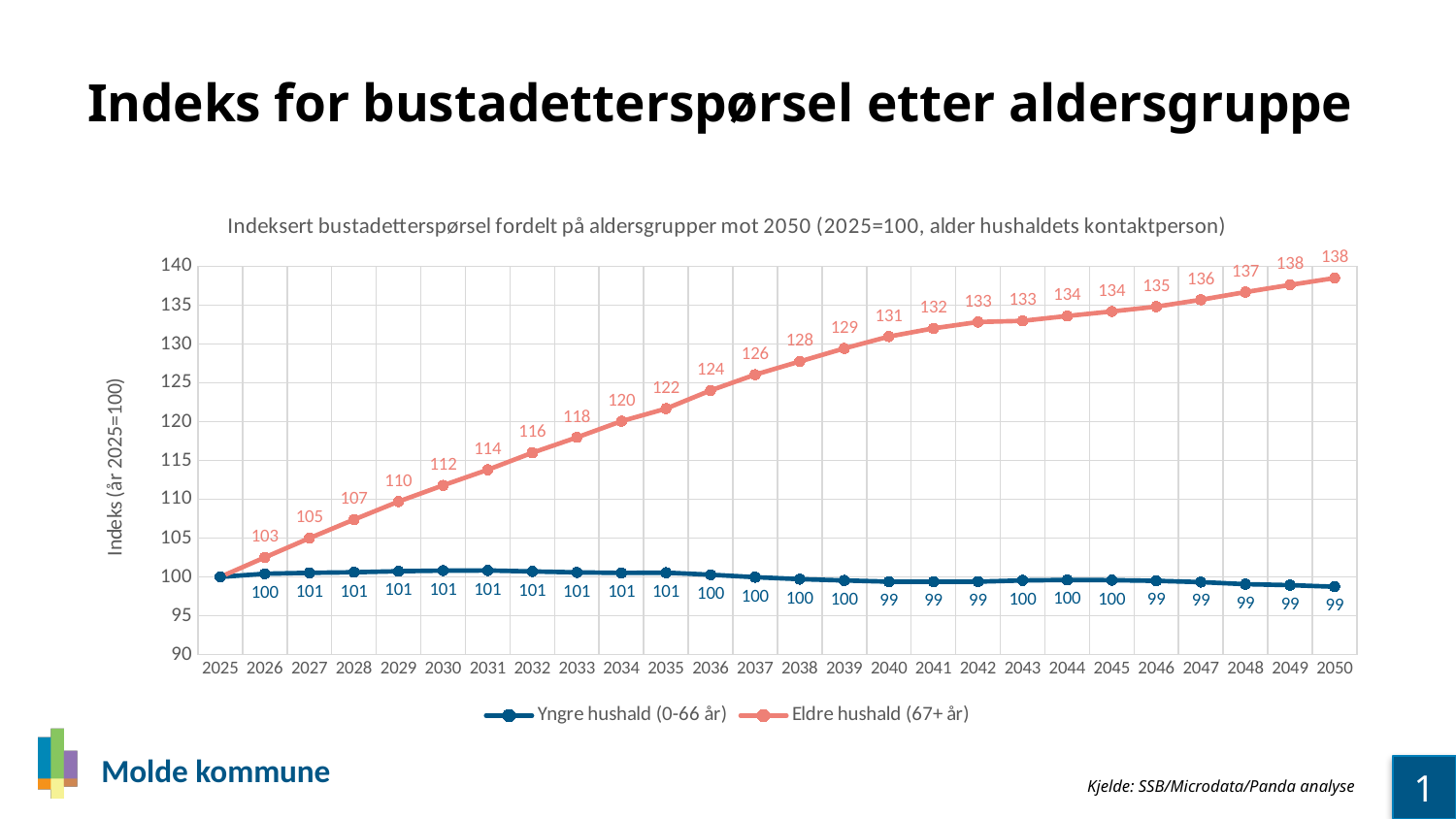
In 2035, which series has the higher value, Eldre hushald (67+ år) or Yngre hushald (0-66 år)? Eldre hushald (67+ år) Does the Eldre hushald (67+ år) series rise or fall from 2025 to 2050? rise How many years are shown on the x axis? 26 What kind of chart is shown on the slide? line chart What is the value for Eldre hushald (67+ år) in 2050? 138 What is the value for Eldre hushald (67+ år) in 2040? 131 What is the difference between the Eldre hushald (67+ år) and Yngre hushald (0-66 år) values in 2050? 39 What is the value for Yngre hushald (0-66 år) in 2050? 99 How many series does the legend list? 2 Is the value for Eldre hushald (67+ år) in 2036 greater or less than 120? greater What is the value for Eldre hushald (67+ år) in 2030? 112 What is the label on the y axis? Indeks (år 2025=100)